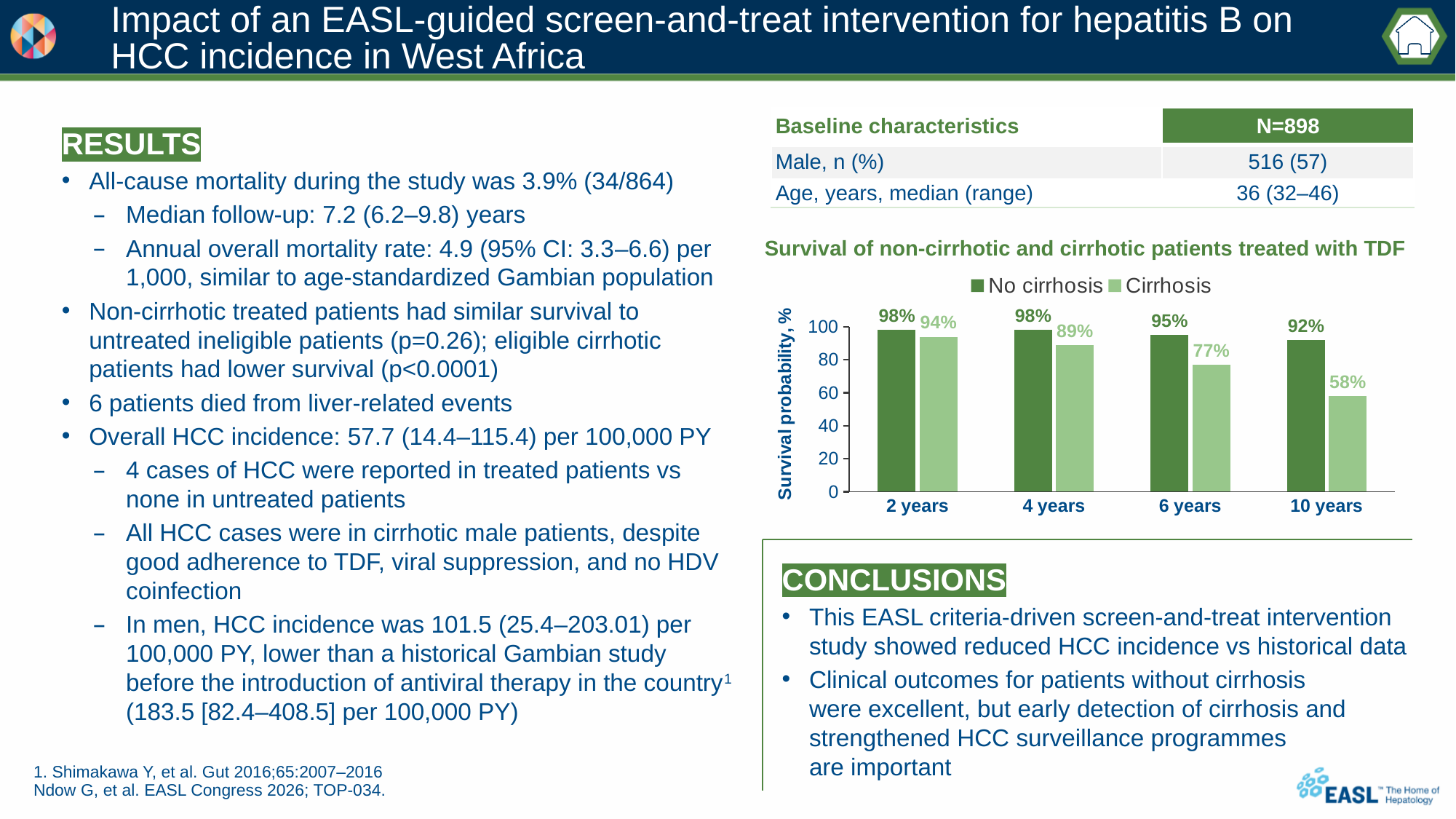
What is the difference between the No cirrhosis and Cirrhosis survival probabilities at 2 years? 4% How many time points are shown on the x axis of the survival chart? 4 Does the survival probability for the Cirrhosis group rise or fall from 2 years to 10 years? Fall At which time point is the survival probability for the Cirrhosis group lowest? 10 years At which time point is the survival probability for the No cirrhosis group lowest? 10 years How many series does the legend of the survival chart list? 2 Which group has the higher survival probability at 6 years, No cirrhosis or Cirrhosis? No cirrhosis What is the survival probability for the Cirrhosis group at 10 years? 58% What kind of chart is used to show survival of non-cirrhotic and cirrhotic patients? Bar chart What is the survival probability for the No cirrhosis group at 6 years? 95% What is the difference between the No cirrhosis and Cirrhosis survival probabilities at 10 years? 34% What is the survival probability for the Cirrhosis group at 4 years? 89%